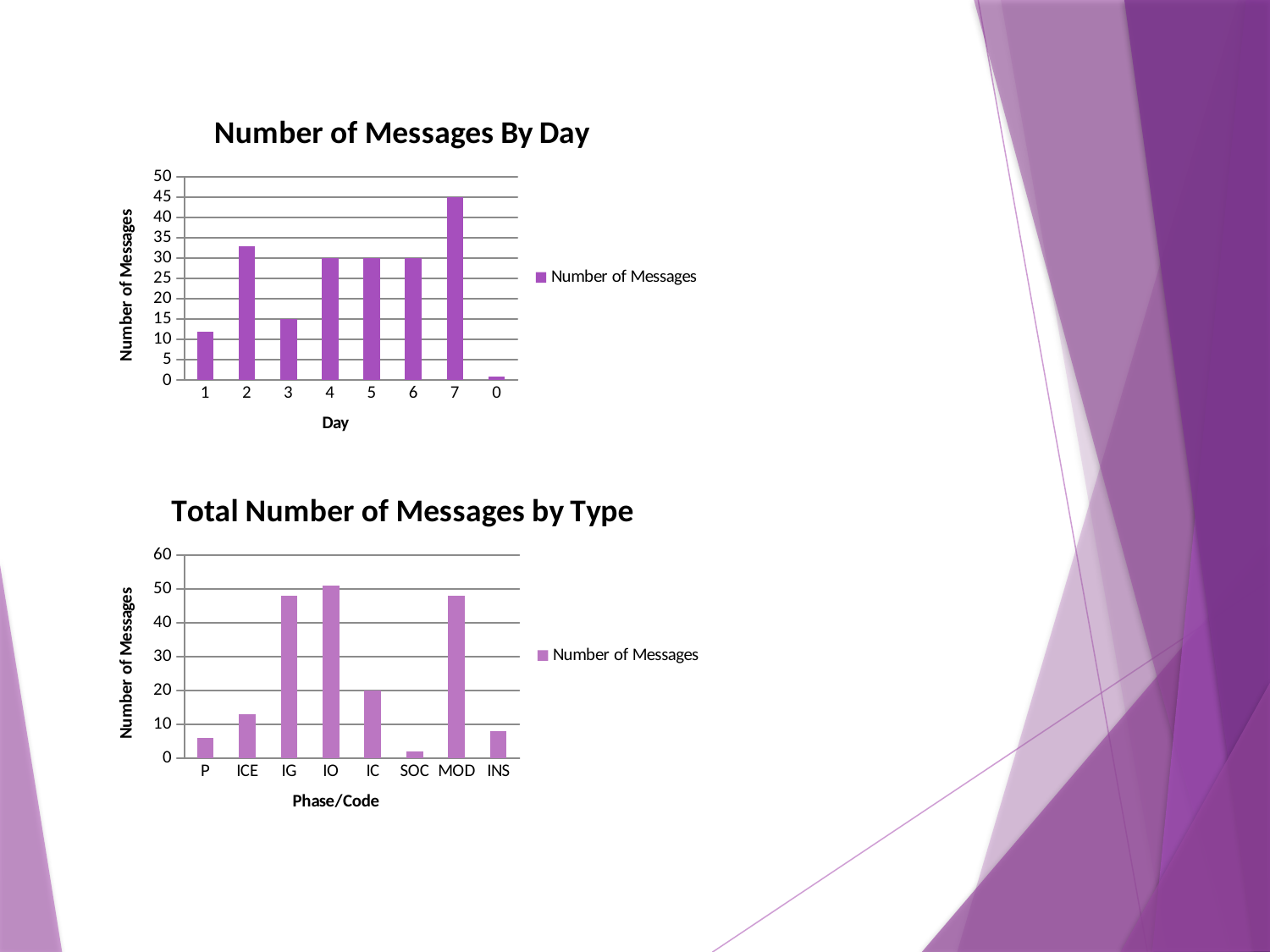
In the 'Number of Messages By Day' chart, is the value for day 1 greater or less than 15? less In the 'Total Number of Messages by Type' chart, which is larger, the value for IC or the value for INS? IC How many days are shown on the x axis of the 'Number of Messages By Day' chart? 8 How many series does the legend of the 'Total Number of Messages by Type' chart list? 1 In the 'Number of Messages By Day' chart, is the value for day 2 greater or less than 30? greater In the 'Number of Messages By Day' chart, which day has the lowest number of messages? 0 In the 'Number of Messages By Day' chart, which day has the highest number of messages? 7 In the 'Total Number of Messages by Type' chart, which phase/code has the highest number of messages? IO In the 'Number of Messages By Day' chart, which is larger, the value for day 2 or the value for day 3? day 2 In the 'Total Number of Messages by Type' chart, is the value for ICE greater or less than 10? greater What type of chart is 'Number of Messages By Day'? bar chart In the 'Total Number of Messages by Type' chart, which phase/code has the lowest number of messages? SOC